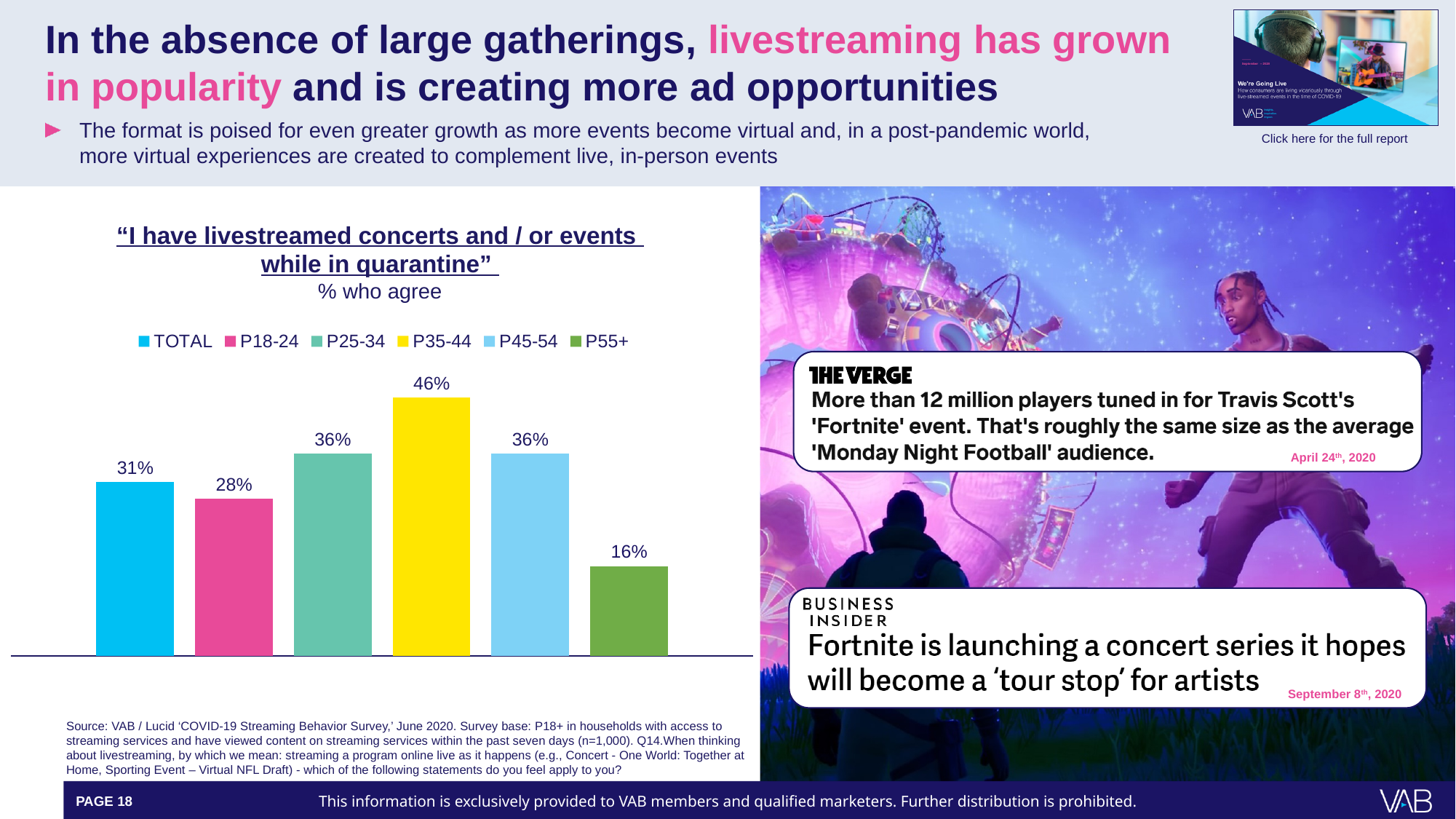
How many entries does the legend list? 6 What percentage of the TOTAL group agrees they have livestreamed concerts and/or events while in quarantine? 31% Which is larger, the value for P18-24 or the value for P45-54? P45-54 What is the difference between the P35-44 value and the P55+ value? 30% What is the value shown for P18-24? 28% Which age group has the lowest percentage who agree? P55+ Which age group has the highest percentage who agree? P35-44 What is the difference between the P25-34 value and the P18-24 value? 8% What kind of chart is shown on the slide? Bar chart What colour is the bar for P35-44? Yellow What is the value shown for P55+? 16% How many bars are plotted in the chart? 6